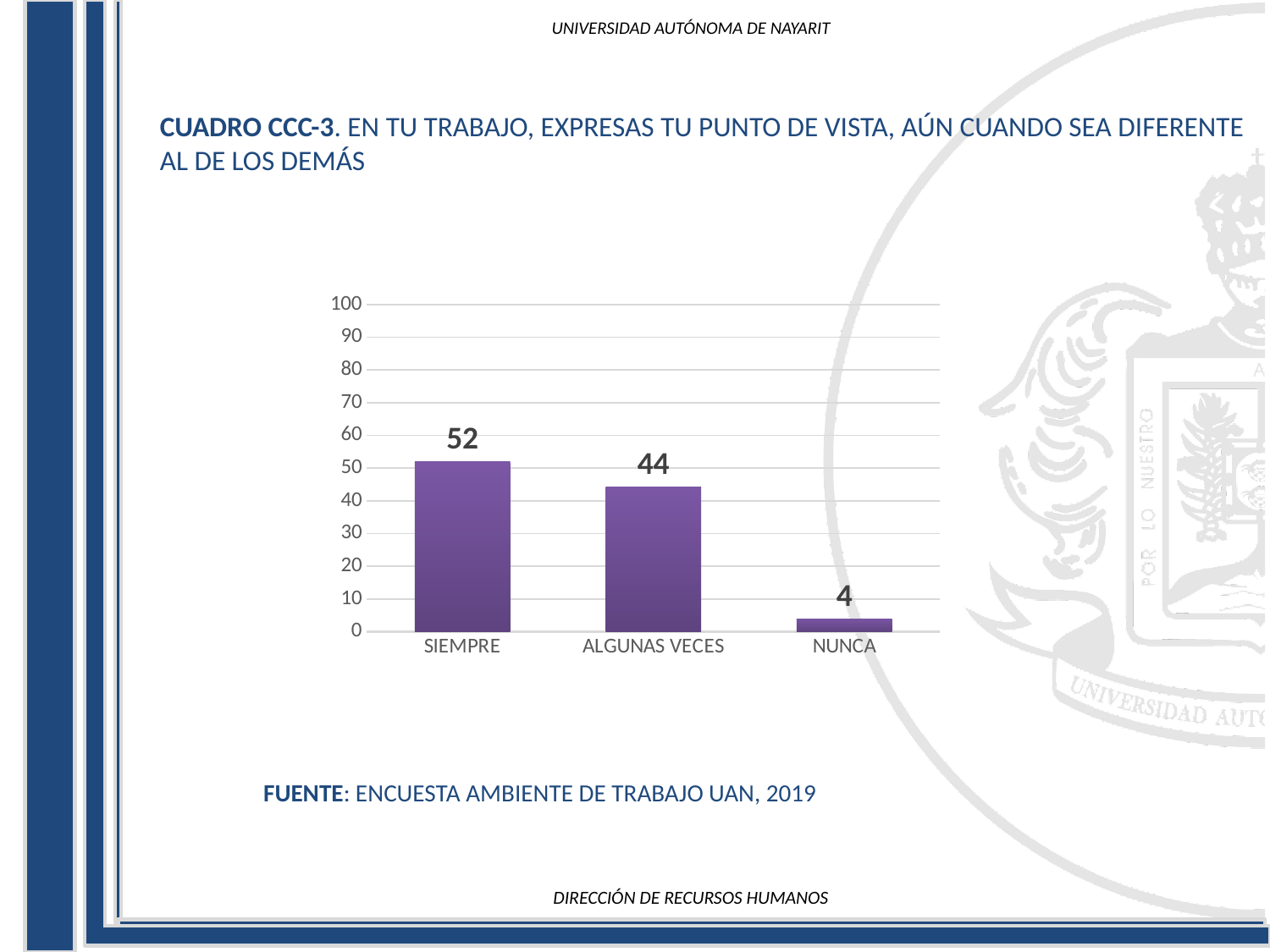
How many categories are shown on the x axis? 3 Is the value for ALGUNAS VECES greater or less than 50? less What is the value for ALGUNAS VECES? 44 What is the highest value shown on the vertical axis? 100 Which is larger, the value for SIEMPRE or the value for NUNCA? SIEMPRE What is the value for NUNCA? 4 What is the value for SIEMPRE? 52 Which category has the lowest value? NUNCA What is the difference between the values for SIEMPRE and ALGUNAS VECES? 8 What kind of chart is shown on the slide? bar chart What is the difference between the values for ALGUNAS VECES and NUNCA? 40 Which category has the highest value? SIEMPRE